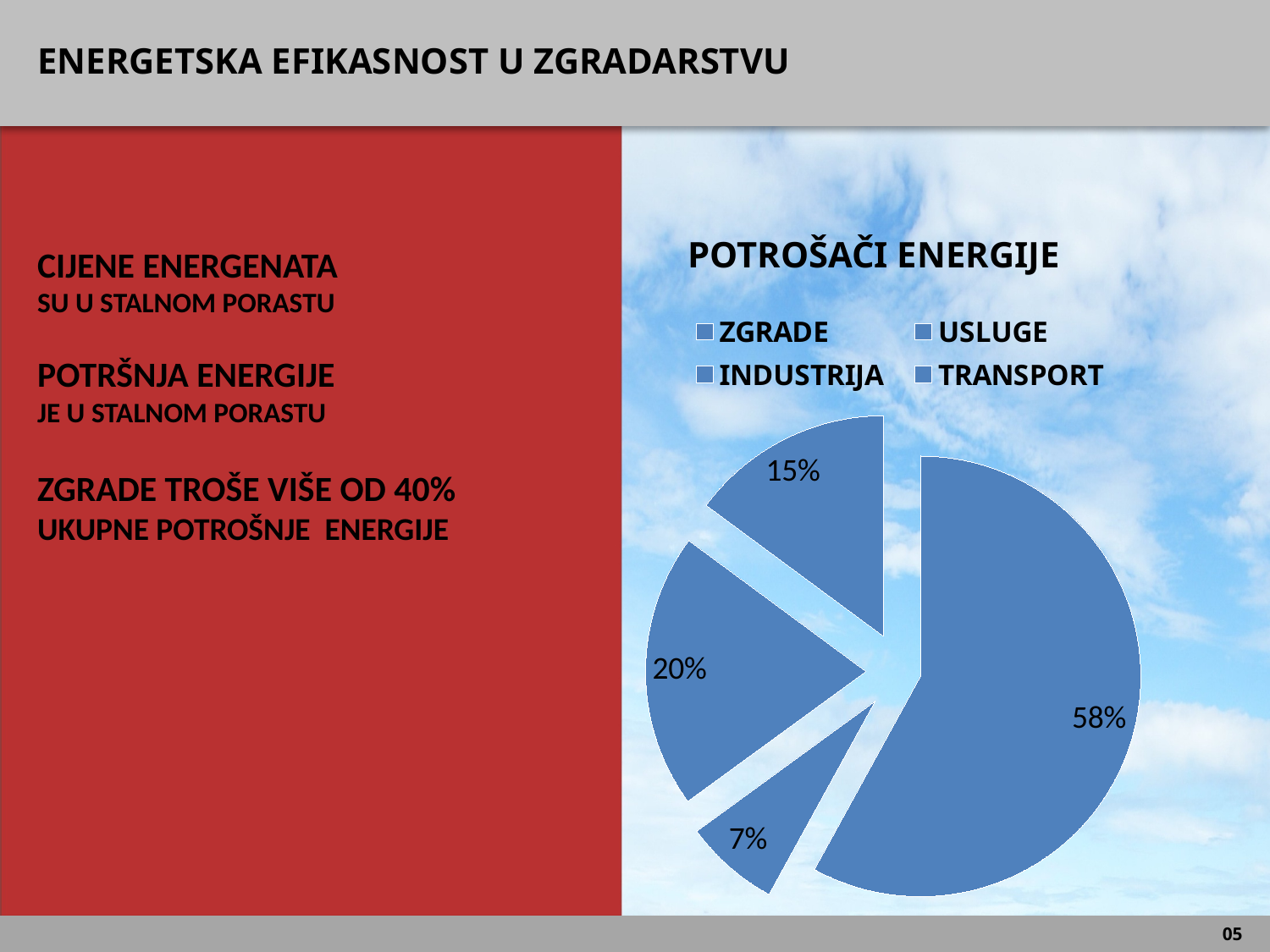
What kind of chart is shown on the slide? pie chart Is the largest slice of the pie chart greater or less than 50%? greater Which legend entries are listed in the pie chart's legend? ZGRADE, USLUGE, INDUSTRIJA, TRANSPORT According to the slide, which category (ZGRADE) accounts for the 58% slice, consistent with the text that buildings use more than 40% of total energy? ZGRADE What do the four slice labels of the pie chart add up to? 100% What is the difference in percentage points between the largest slice (58%) and the smallest slice (7%)? 51 What is the share of the largest slice in the pie chart? 58% What is the share of the smallest slice in the pie chart? 7% How many slices does the pie chart have? 4 How many entries does the legend of the pie chart list? 4 Which is larger, the 20% slice or the 15% slice? 20% What is the title of the pie chart? POTROŠAČI ENERGIJE